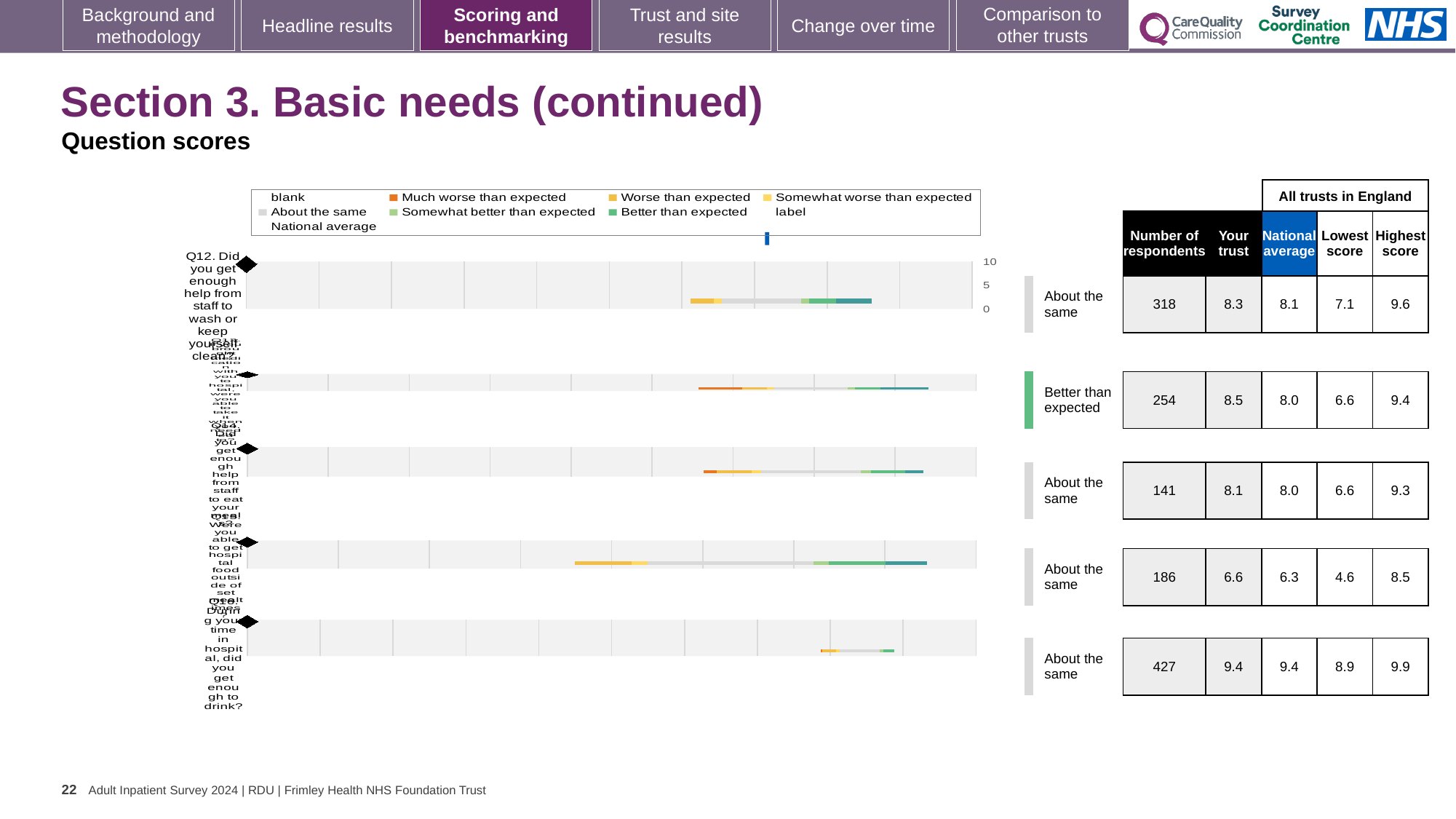
Which legend entry is shown in orange in the chart legend? Much worse than expected For Q12 (help from staff to wash or keep yourself clean), what is the 'Your trust' score? 8.3 For Q12 (help from staff to wash or keep yourself clean), what is the national average score? 8.1 For Q12 (help from staff to wash or keep yourself clean), what is the highest score among all trusts in England? 9.6 For the fourth question row, what is the lowest score among all trusts in England? 4.6 For Q12 (help from staff to wash or keep yourself clean), what is the number of respondents shown in the table? 318 Which row of the chart is rated 'Better than expected'? the second row What kind of chart is used to show the question scores on this slide? bar chart How many question rows are plotted in the chart? 5 Which legend entry is shown in light grey in the chart legend? About the same For the second question row (rated 'Better than expected'), what is the 'Your trust' score? 8.5 Which question row has the highest 'Your trust' score in the table? the fifth row (9.4)